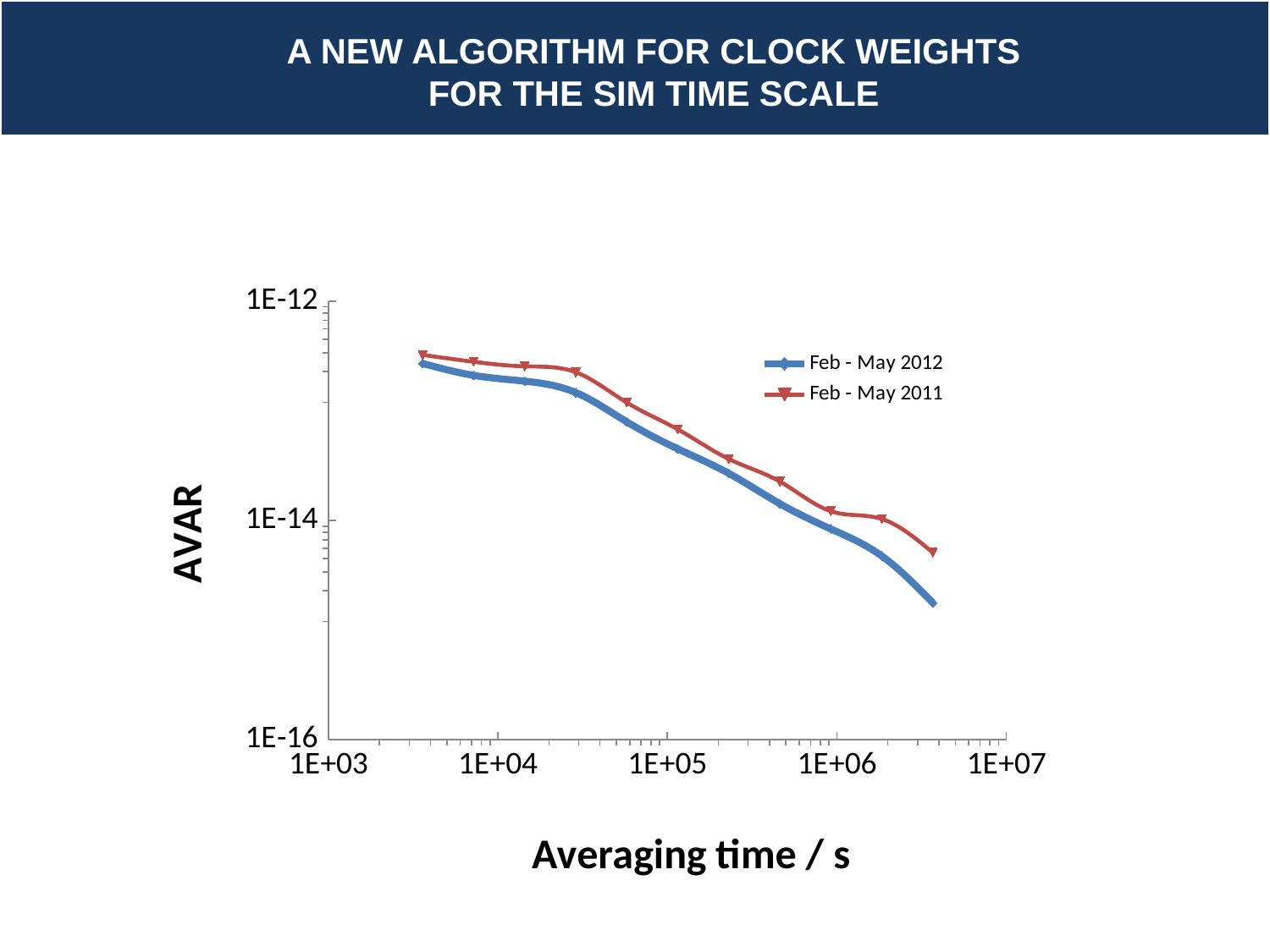
Do the AVAR values rise or fall as averaging time increases? Fall Is the AVAR value for Feb - May 2011 at the smallest averaging time greater or less than 1E-14? greater Is the AVAR value for Feb - May 2012 at the smallest averaging time greater or less than 1E-12? less Which series is plotted in red? Feb - May 2011 What kind of chart is shown on the slide? Line chart What is the label of the x axis? Averaging time / s Which series has the higher AVAR values across the averaging times shown, Feb - May 2012 or Feb - May 2011? Feb - May 2011 How many series does the legend list? 2 Is the AVAR value for Feb - May 2011 at an averaging time of 1E+05 s greater or less than 1E-14? greater Which series has the lower AVAR at the largest averaging time plotted? Feb - May 2012